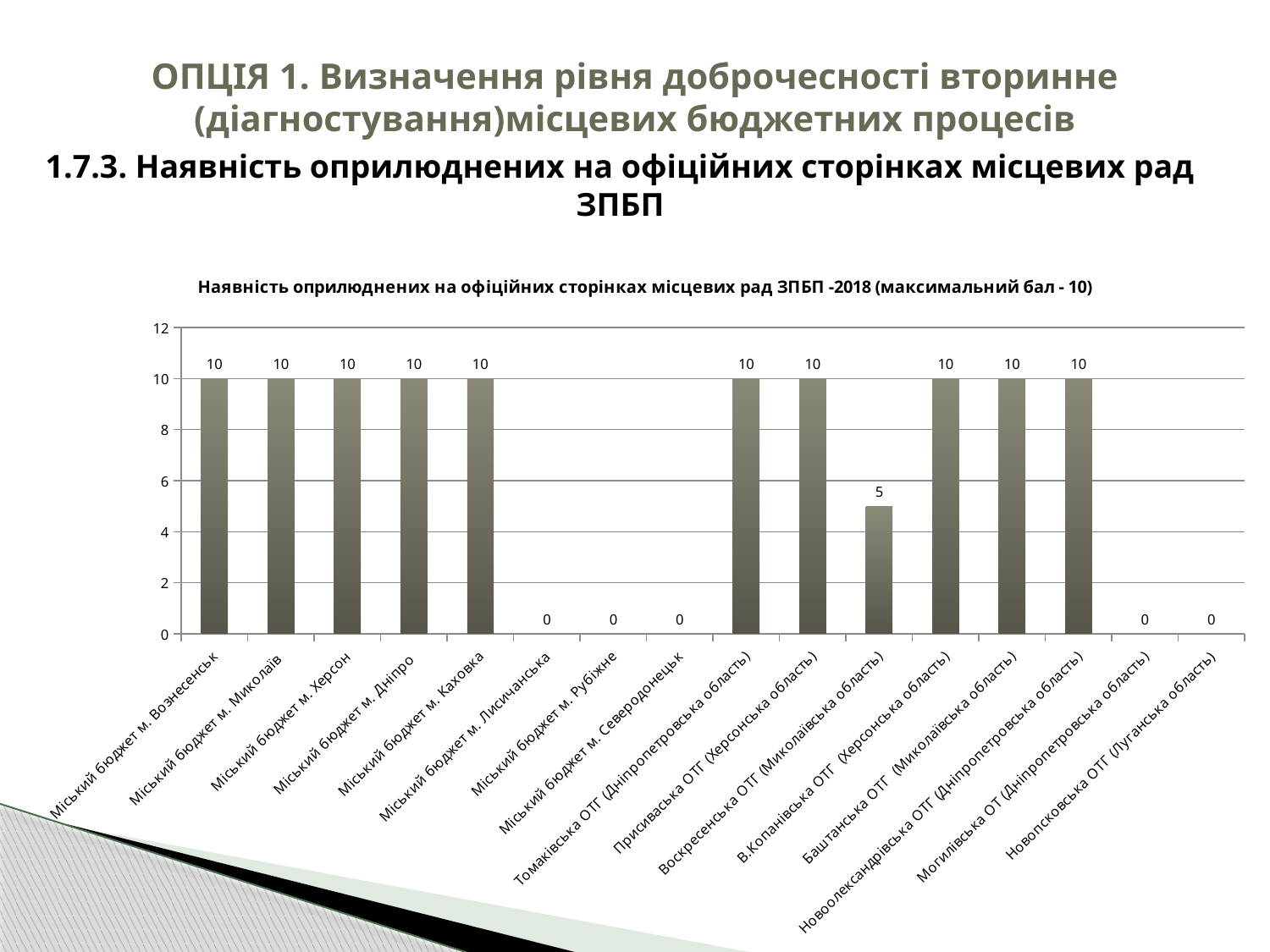
What value is shown for Міський бюджет м. Лисичанська? 0 Which has the larger value: Міський бюджет м. Херсон or Міський бюджет м. Рубіжне? Міський бюджет м. Херсон How many categories have a value of 10? 10 How many categories have a value of 0? 5 What is the difference between the value for Томаківська ОТГ (Дніпропетровська область) and the value for Воскресенська ОТГ (Миколаївська область)? 5 What kind of chart is shown on the slide? bar chart What value is shown for Новопсковська ОТГ (Луганська область)? 0 What value is shown for Баштанська ОТГ (Миколаївська область)? 10 Is the value for Воскресенська ОТГ (Миколаївська область) greater or less than 8? less According to the chart title, what is the maximum score (максимальний бал)? 10 What value is shown for Воскресенська ОТГ (Миколаївська область)? 5 How many categories are shown on the x axis of the chart? 16